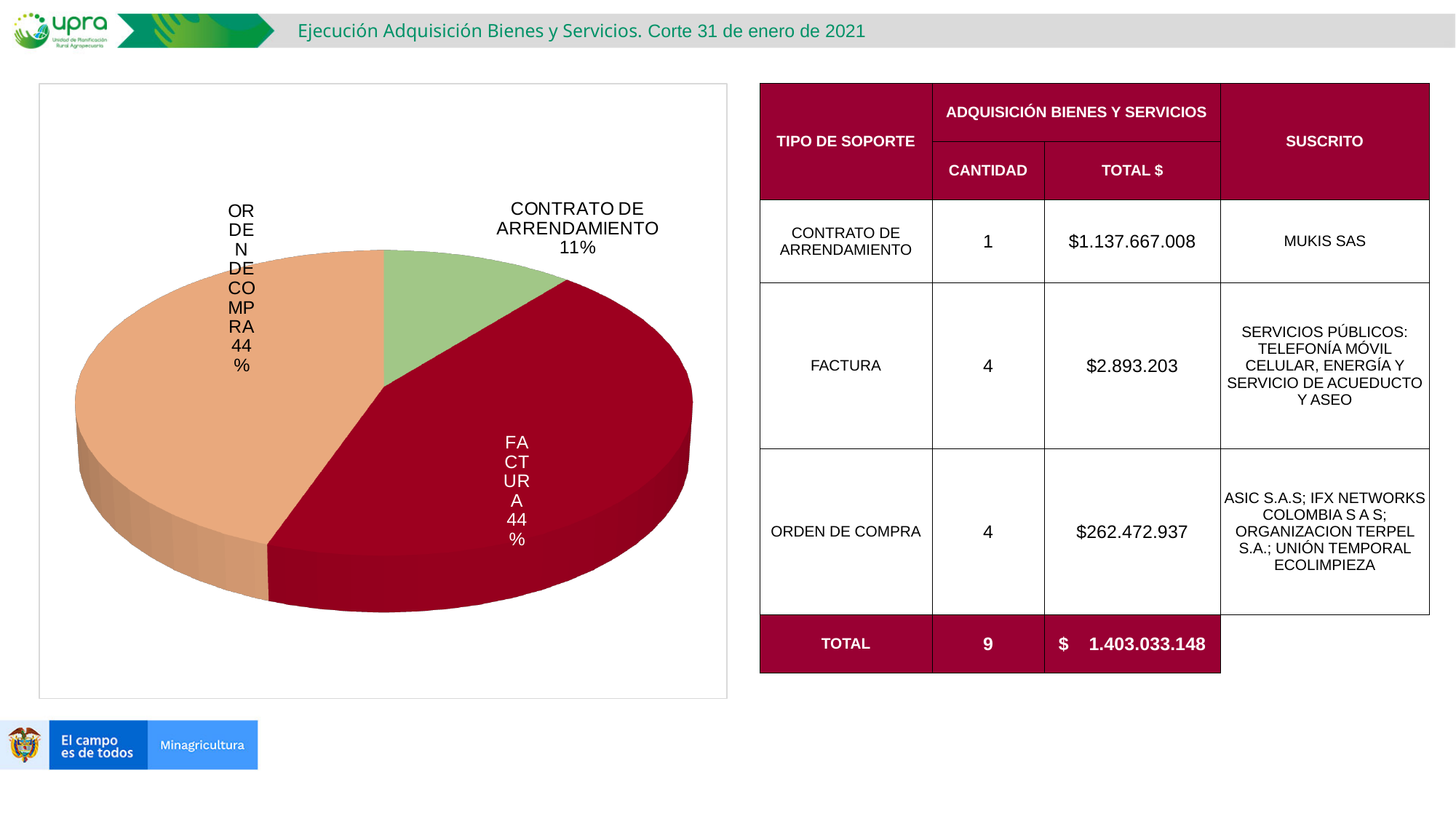
What share of the pie chart does FACTURA represent? 44% What colour is the CONTRATO DE ARRENDAMIENTO slice in the pie chart? Green Which category has the smallest slice in the pie chart? CONTRATO DE ARRENDAMIENTO What is the difference in percentage points between the ORDEN DE COMPRA slice and the CONTRATO DE ARRENDAMIENTO slice? 33 percentage points What colour is the FACTURA slice in the pie chart? Dark red What share of the pie chart does CONTRATO DE ARRENDAMIENTO represent? 11% Do the FACTURA and ORDEN DE COMPRA slices show the same percentage? Yes, both 44% What share of the pie chart does ORDEN DE COMPRA represent? 44% How many slices does the pie chart have? 3 Which slice is larger in the pie chart, FACTURA or CONTRATO DE ARRENDAMIENTO? FACTURA What type of chart is shown on the slide? Pie chart